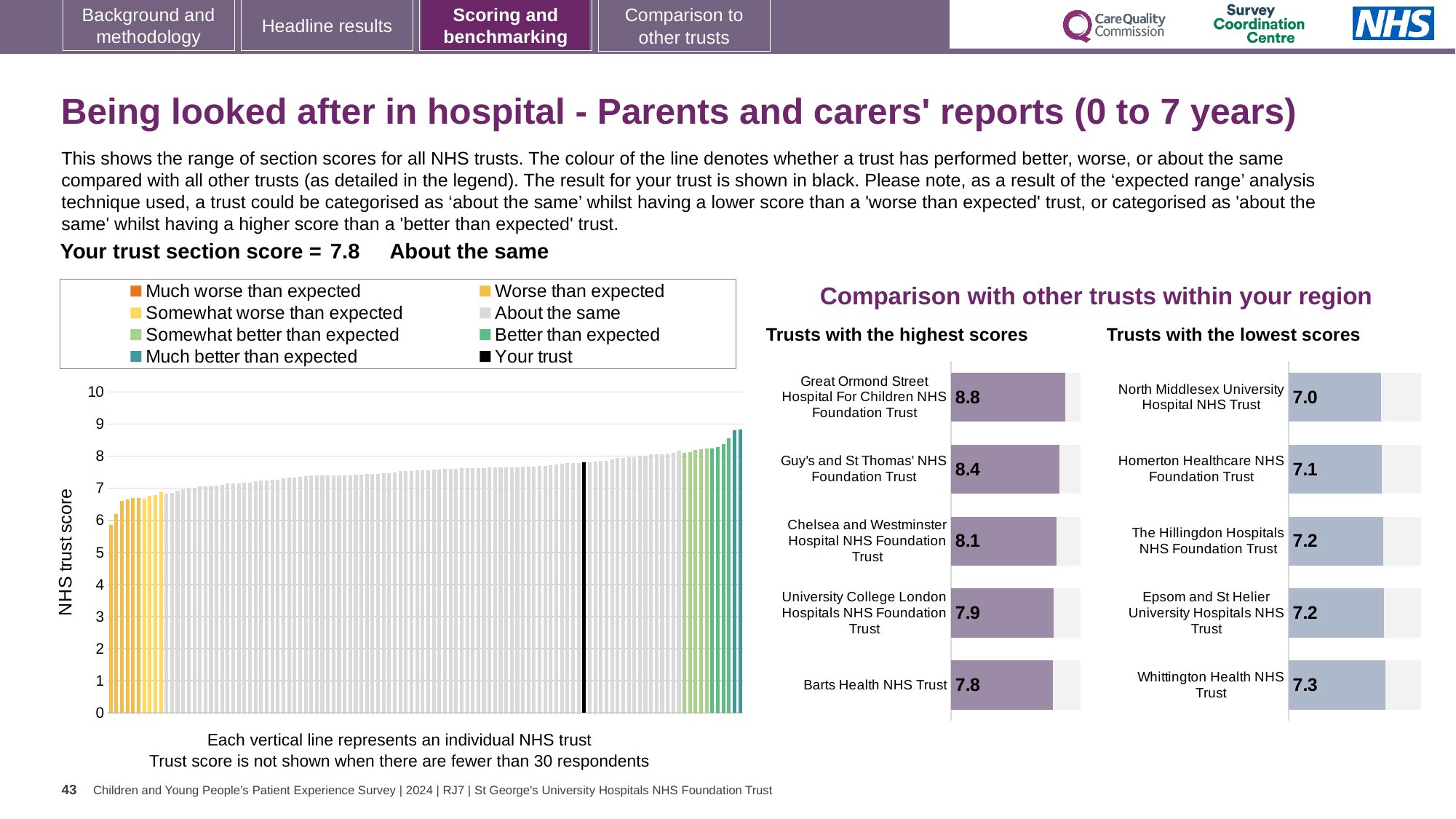
In the 'Trusts with the highest scores' chart, what is the difference between the scores of Great Ormond Street Hospital For Children NHS Foundation Trust and Barts Health NHS Trust? 1.0 How many entries does the legend of the main 'NHS trust score' chart on the left list? 8 In the 'Trusts with the lowest scores' chart, which has the higher score: Homerton Healthcare NHS Foundation Trust or Whittington Health NHS Trust? Whittington Health NHS Trust In the main 'NHS trust score' chart on the left, do the bar values rise or fall from left to right? rise In the 'Trusts with the lowest scores' chart, what is the difference between the scores of Whittington Health NHS Trust and North Middlesex University Hospital NHS Trust? 0.3 How many trusts are shown in the 'Trusts with the highest scores' chart? 5 In the 'Trusts with the highest scores' chart, what is the score for Great Ormond Street Hospital For Children NHS Foundation Trust? 8.8 In the 'Trusts with the lowest scores' chart, which trust has the lowest score? North Middlesex University Hospital NHS Trust In the 'Trusts with the lowest scores' chart, what is the score for Whittington Health NHS Trust? 7.3 In the 'Trusts with the highest scores' chart, which trust has the highest score? Great Ormond Street Hospital For Children NHS Foundation Trust In the main 'NHS trust score' chart on the left, is the value of the tallest bar greater or less than 8? greater In the 'Trusts with the highest scores' chart, what is the score for Barts Health NHS Trust? 7.8